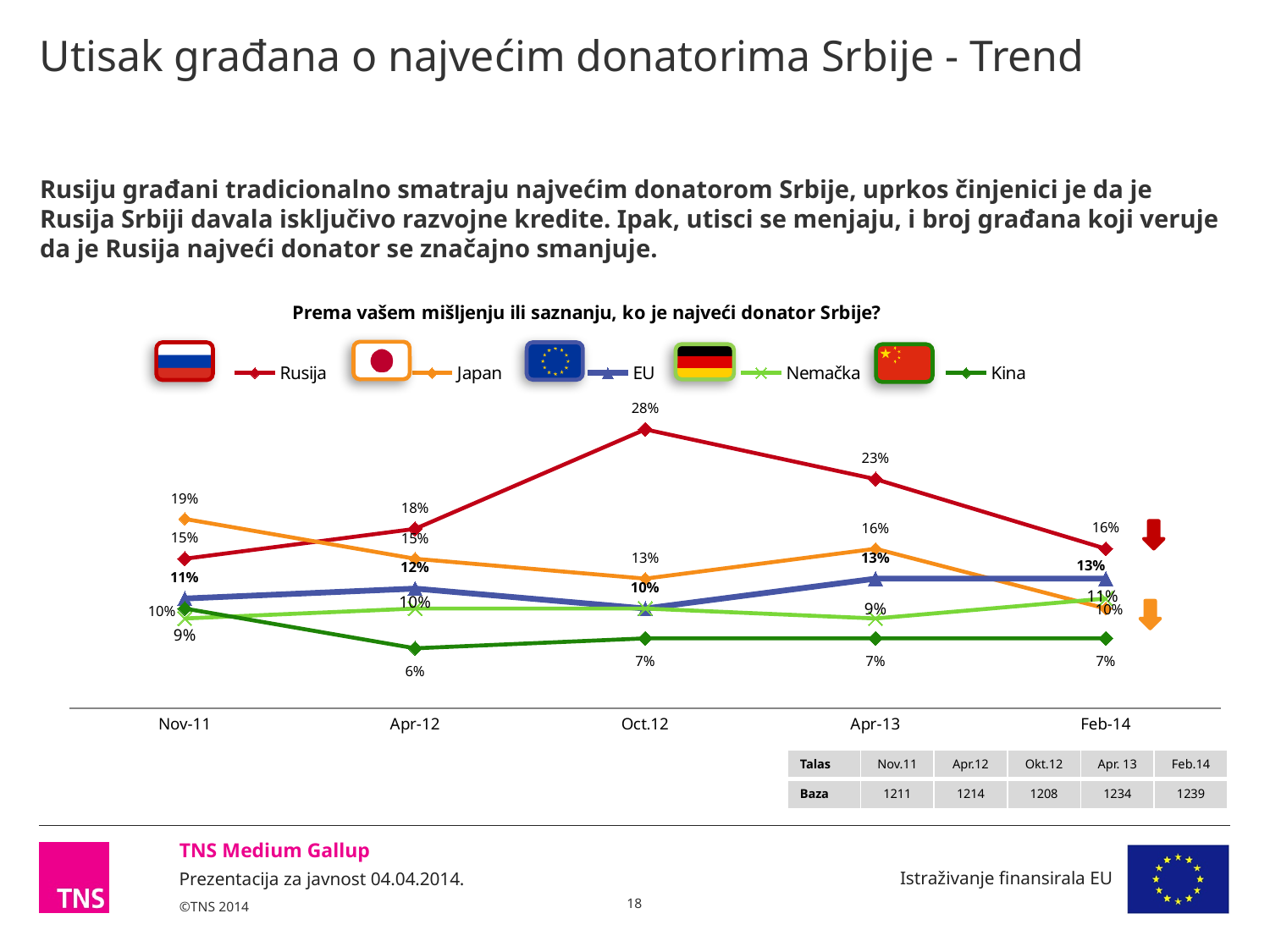
What is the value for Japan at Nov-11? 19% What is the value for EU at Apr-13? 13% What is the difference between the Rusija value at Oct.12 and at Feb-14? 12 percentage points How many time points are shown on the x axis of the chart? 5 What is the value for Rusija at Feb-14? 16% At which time point does Kina have its lowest value? Apr-12 What type of chart is shown on the slide? Line chart What is the value for Kina at Apr-12? 6% At which time point does Rusija reach its highest value? Oct.12 Does the Rusija line rise or fall from Oct.12 to Feb-14? Fall What is the value for Rusija at Oct.12? 28% How many series does the chart legend list? 5